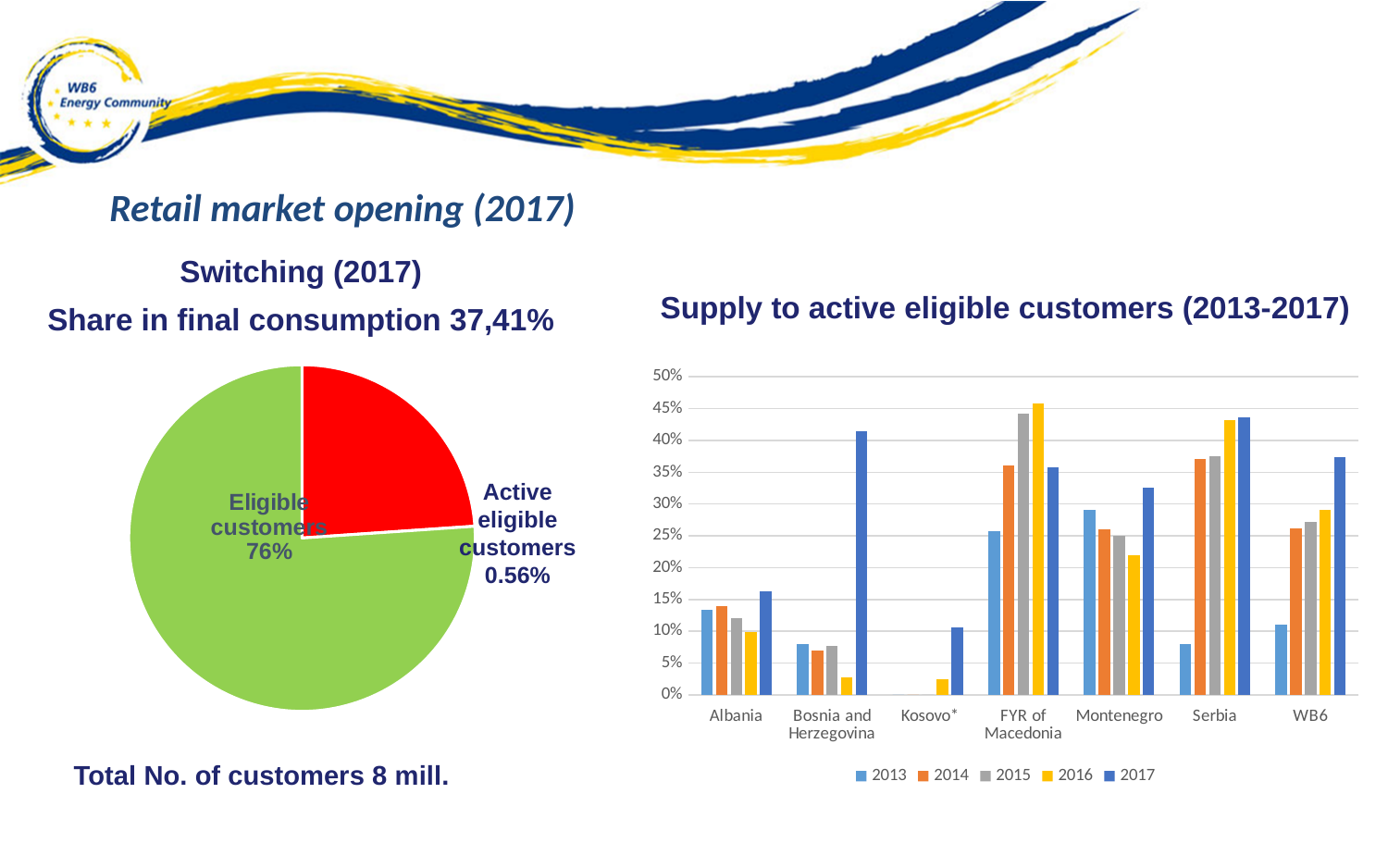
How many series does the legend of 'Supply to active eligible customers (2013-2017)' list? 5 What kind of chart is 'Supply to active eligible customers (2013-2017)'? Bar chart In 'Supply to active eligible customers (2013-2017)', which is larger for 2013: Albania or Bosnia and Herzegovina? Albania In 'Supply to active eligible customers (2013-2017)', is the 2017 value for Albania greater or less than 20%? less In 'Supply to active eligible customers (2013-2017)', which colour represents the 2016 series in the legend? Yellow In the pie chart on the left, what share is shown for Active eligible customers? 0.56% What kind of chart is the chart on the left of the slide? Pie chart In 'Supply to active eligible customers (2013-2017)', which category has the highest 2016 value? FYR of Macedonia In 'Supply to active eligible customers (2013-2017)', is the 2016 value for FYR of Macedonia greater or less than 40%? greater How many categories are shown on the x axis of 'Supply to active eligible customers (2013-2017)'? 7 In 'Supply to active eligible customers (2013-2017)', is the 2017 value for Bosnia and Herzegovina greater or less than 35%? greater In the pie chart on the left, what share is shown for Eligible customers? 76%